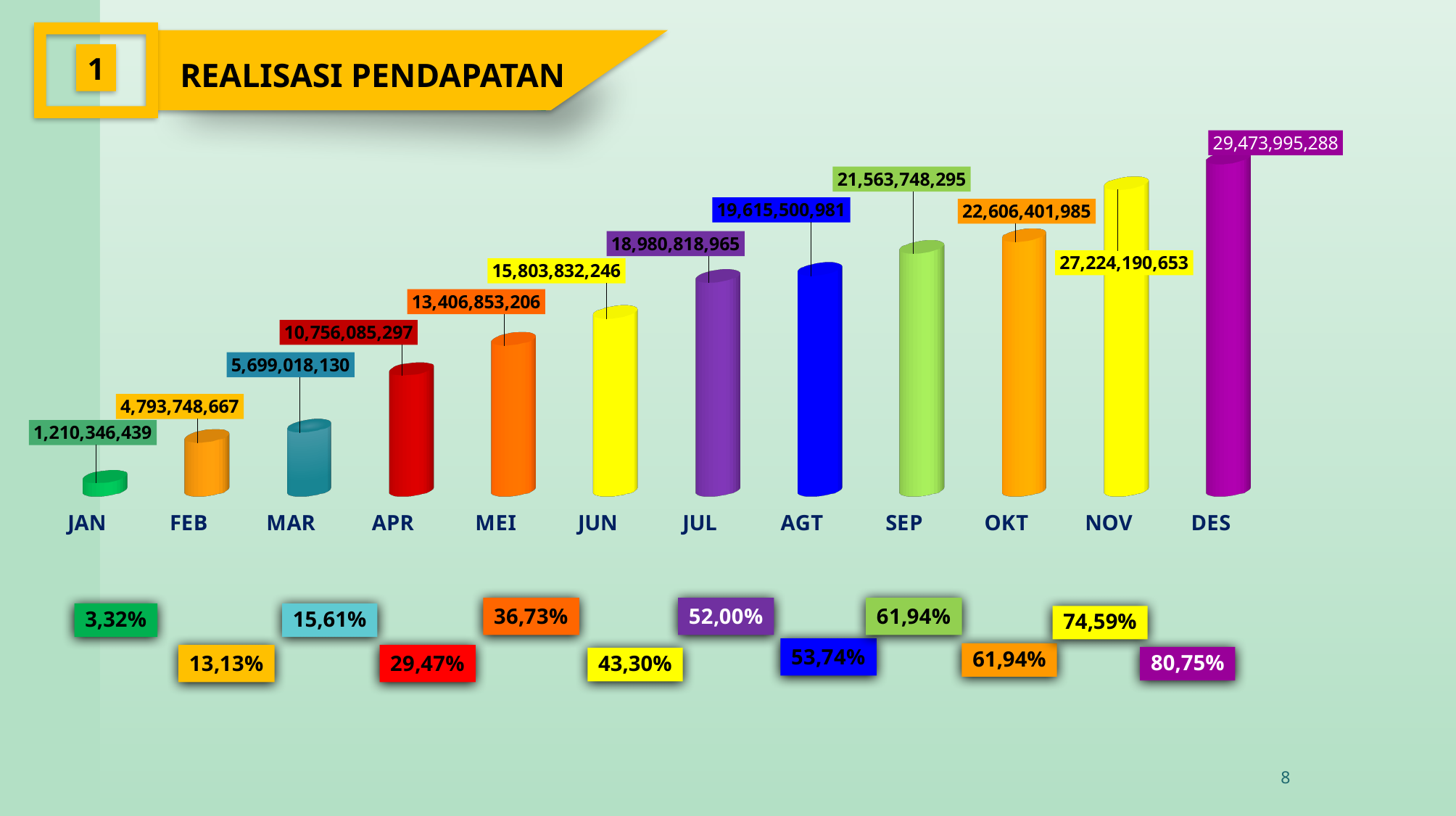
What is the value for OKT? 22,606,401,985 Which month has the highest value? DES What kind of chart is shown on the slide? bar chart What is the value for MEI? 13,406,853,206 Do the values rise or fall from JAN to DES? rise What is the value for JAN? 1,210,346,439 What is the difference between the values for DES and NOV? 2,249,804,635 Which is larger, the value for APR or the value for MAR? APR What is the difference between the values for FEB and JAN? 3,583,402,228 Which month has the lowest value? JAN How many months are shown on the chart? 12 What is the value for JUL? 18,980,818,965